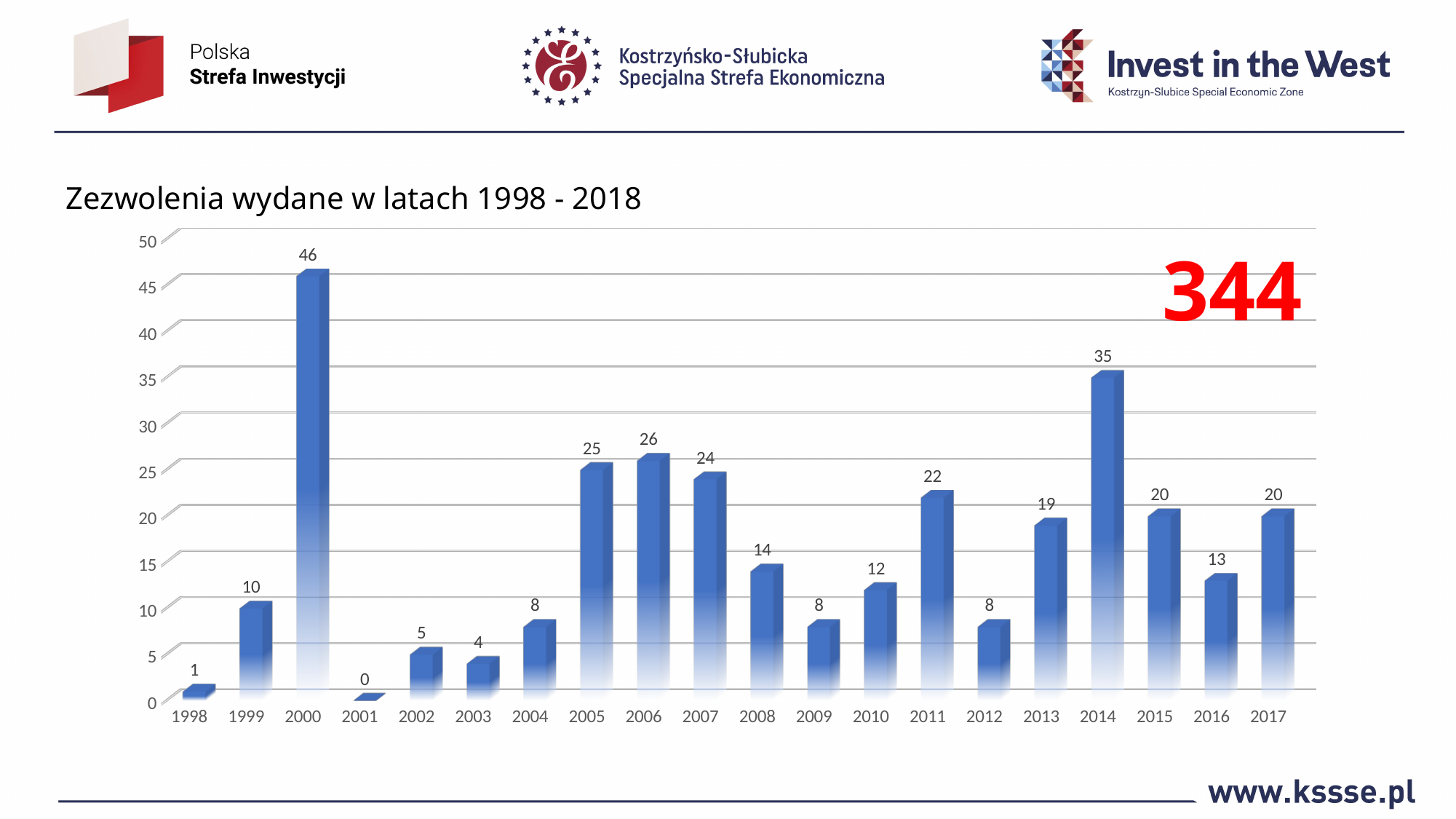
What is the title of the chart? Zezwolenia wydane w latach 1998 - 2018 Which year has the lowest value? 2001 What value is shown for 2000? 46 Is the value for 2005 greater or less than 20? greater What is the difference between the values for 2000 and 2014? 11 Which year has the highest value? 2000 What value is shown for 2008? 14 How many years are shown on the x axis? 20 What is the difference between the values for 2006 and 2007? 2 What kind of chart is shown on the slide? bar chart What value is shown for 2014? 35 Which is larger, the value for 2011 or the value for 2013? 2011